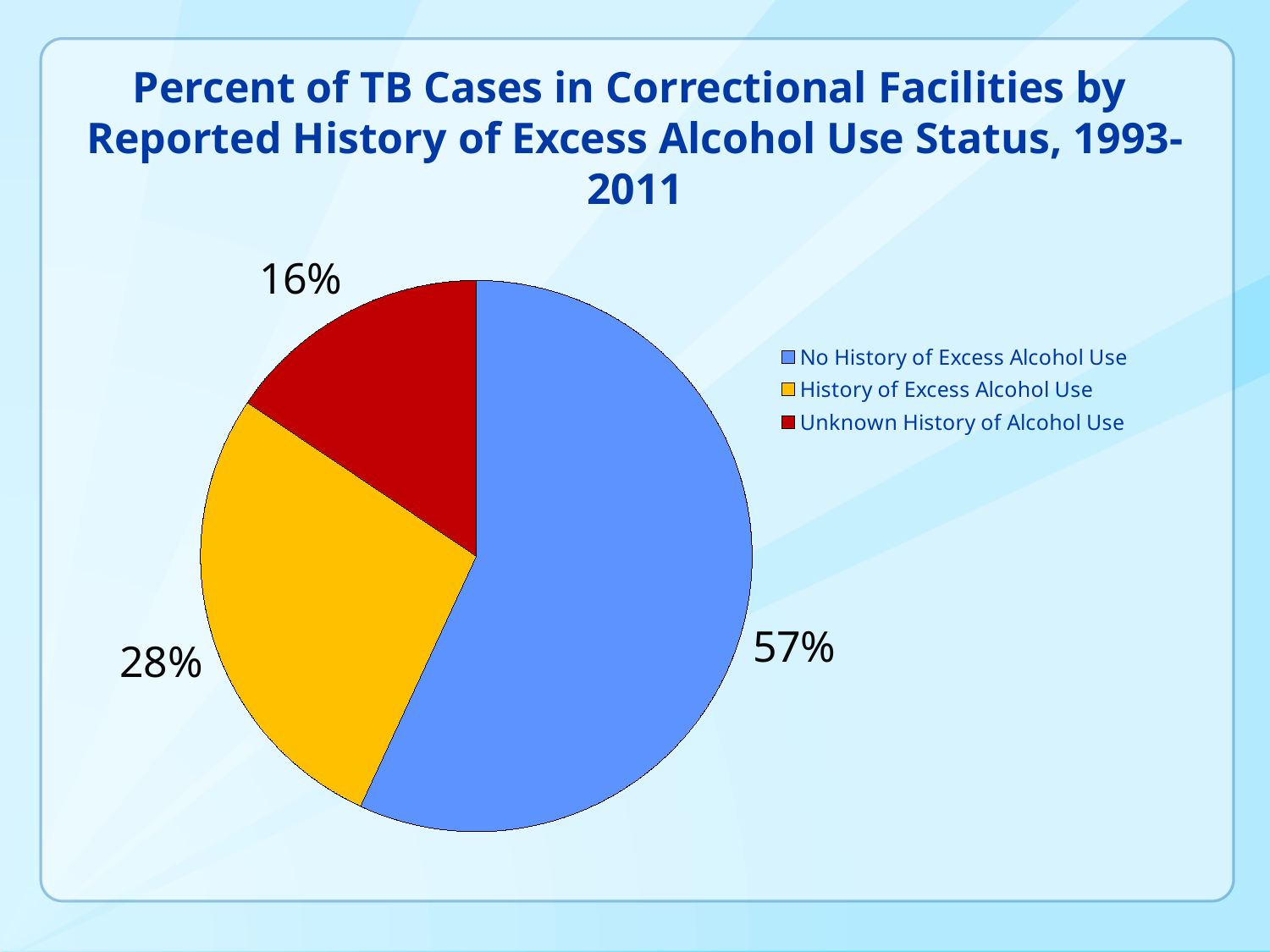
What percent of TB cases in correctional facilities had an unknown history of alcohol use? 16% What kind of chart is shown on the slide? Pie chart Which category accounts for the smallest share of TB cases in correctional facilities? Unknown History of Alcohol Use What time period does the chart title cover? 1993-2011 How many categories does the pie chart show? 3 What percent of TB cases in correctional facilities had a history of excess alcohol use? 28% Which category accounts for the largest share of TB cases in correctional facilities? No History of Excess Alcohol Use What is the difference in percentage points between the History of Excess Alcohol Use slice and the Unknown History of Alcohol Use slice? 12 Which is larger: the share with a history of excess alcohol use or the share with an unknown history of alcohol use? History of Excess Alcohol Use What is the difference in percentage points between the No History of Excess Alcohol Use slice and the History of Excess Alcohol Use slice? 29 What colour is the slice for Unknown History of Alcohol Use? Red What percent of TB cases in correctional facilities had no history of excess alcohol use? 57%